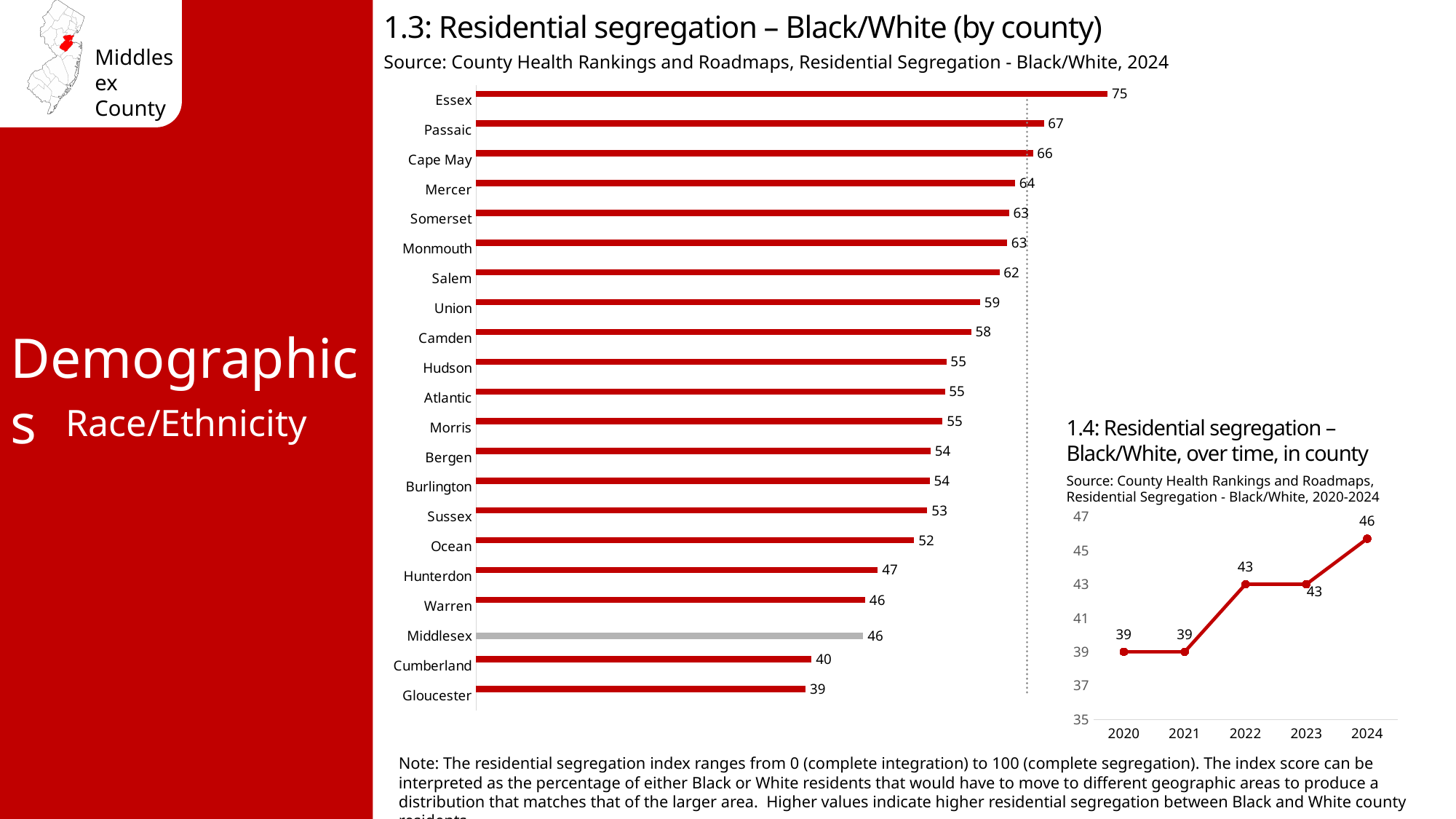
In the chart '1.3: Residential segregation – Black/White (by county)', which county has the lowest value? Gloucester In the chart '1.4: Residential segregation – Black/White, over time, in county', what is the difference between the 2024 and 2020 values? 7 In the chart '1.4: Residential segregation – Black/White, over time, in county', do the values rise or fall from 2020 to 2024? Rise What kind of chart is '1.3: Residential segregation – Black/White (by county)'? Bar chart In the chart '1.3: Residential segregation – Black/White (by county)', what is the value for Cape May? 66 In the chart '1.3: Residential segregation – Black/White (by county)', which county has the highest value? Essex In the chart '1.3: Residential segregation – Black/White (by county)', which has a larger value, Passaic or Union? Passaic In the chart '1.3: Residential segregation – Black/White (by county)', how many counties are shown? 21 In the chart '1.4: Residential segregation – Black/White, over time, in county', what is the value for 2022? 43 In the chart '1.3: Residential segregation – Black/White (by county)', what is the value for Middlesex? 46 In the chart '1.3: Residential segregation – Black/White (by county)', what is the difference between the values for Essex and Gloucester? 36 What kind of chart is '1.4: Residential segregation – Black/White, over time, in county'? Line chart